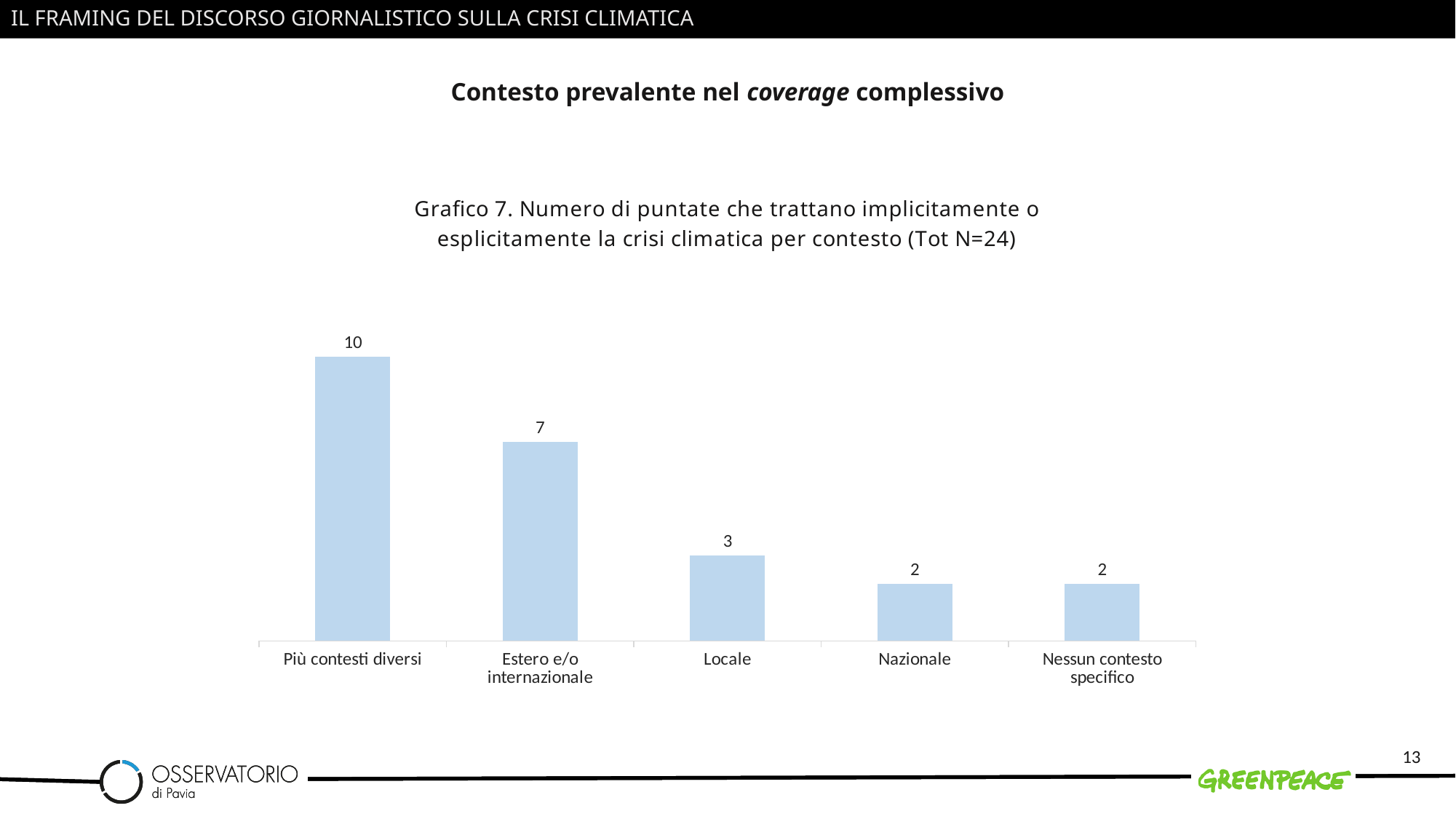
How many categories are shown on the x axis? 5 What is the value for Estero e/o internazionale? 7 What is the difference between the values for Estero e/o internazionale and Locale? 4 Do the values rise or fall from left to right along the x axis? Fall What is the difference between the values for Più contesti diversi and Estero e/o internazionale? 3 What is the value for Locale? 3 What is the value for Nazionale? 2 What is the value for Più contesti diversi? 10 Which is larger, the value for Locale or the value for Nessun contesto specifico? Locale What is the title of the chart? Grafico 7. Numero di puntate che trattano implicitamente o esplicitamente la crisi climatica per contesto (Tot N=24) What kind of chart is shown on the slide? Bar chart Which category has the highest value? Più contesti diversi